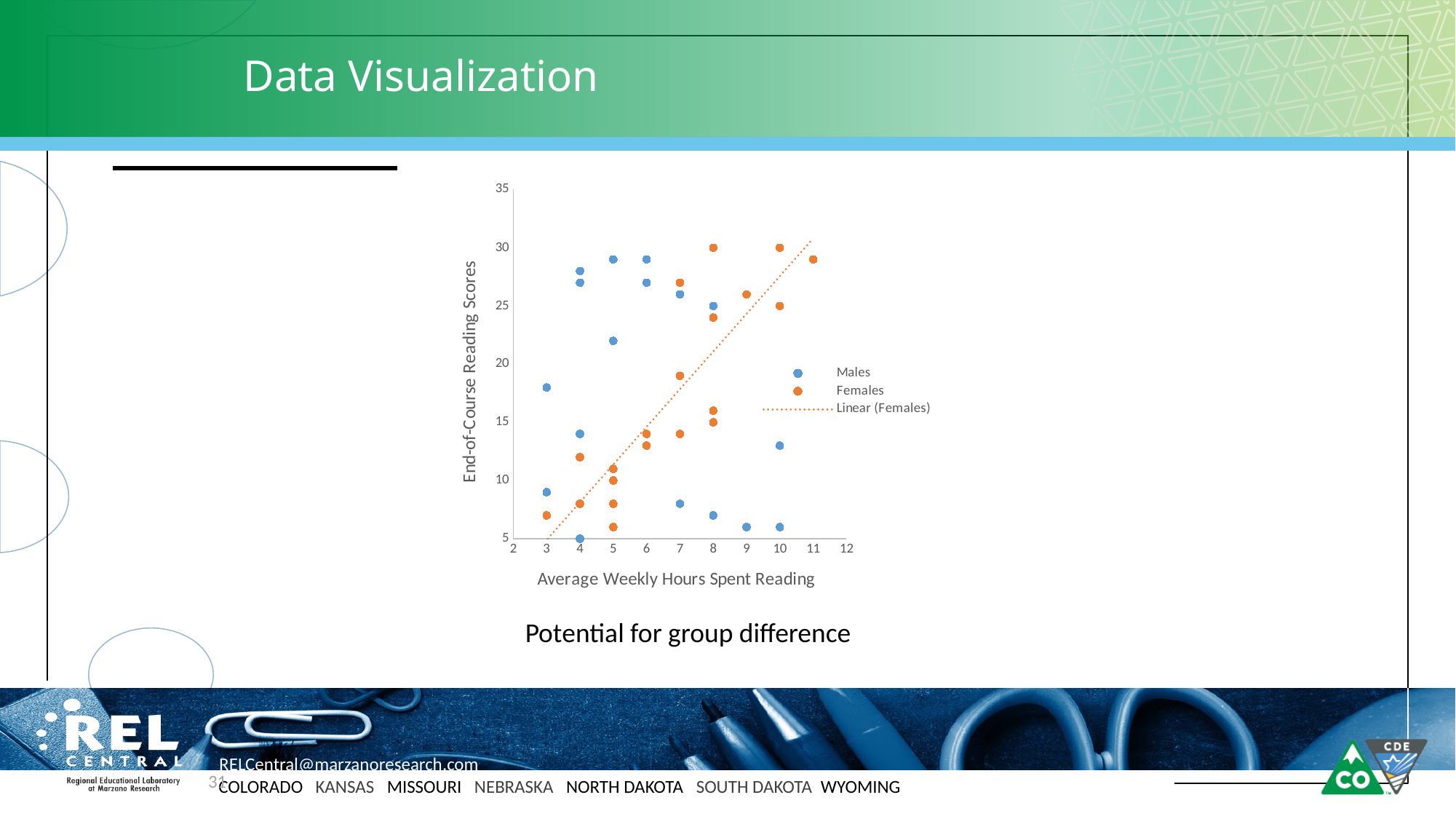
Is the highest Females point on the chart greater or less than 25 on the End-of-Course Reading Scores axis? greater How many entries does the chart's legend list? 3 What is the title of the chart's vertical axis? End-of-Course Reading Scores What is the maximum value shown on the chart's vertical axis? 35 Is the lowest Females point on the chart greater or less than 10 on the End-of-Course Reading Scores axis? less What kind of chart is shown on the slide? scatter chart What are the two data series plotted in the chart? Males and Females Does the dotted Linear (Females) trendline rise or fall as Average Weekly Hours Spent Reading increases? rise Is the highest Males point on the chart greater or less than 25 on the End-of-Course Reading Scores axis? greater